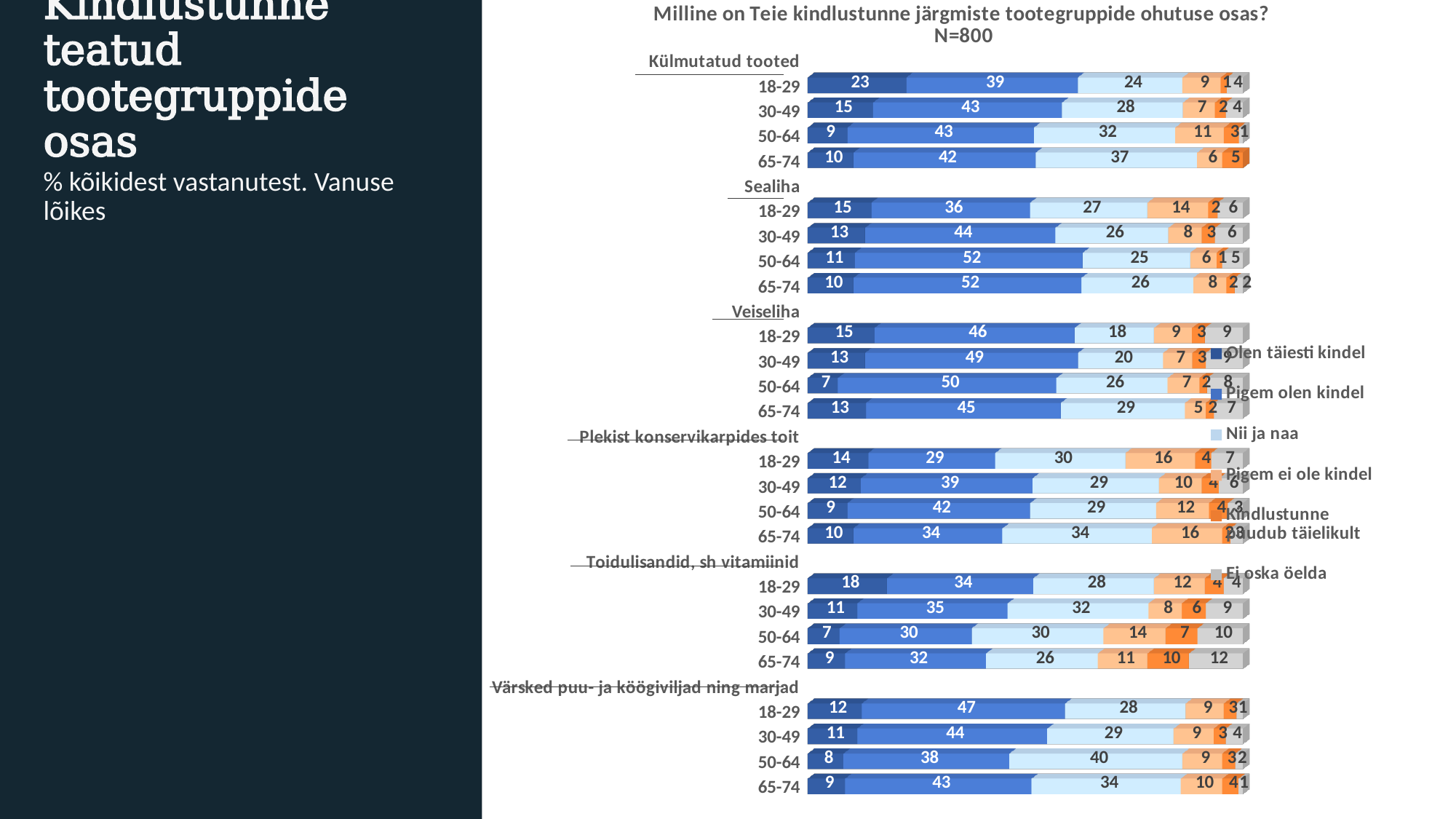
Within Veiseliha, which age group has the highest "Pigem olen kindel" value? 50-64 For Sealiha, what is the "Pigem olen kindel" value for the 50-64 age group? 52 What kind of chart is shown on the slide? Stacked bar chart For Värsked puu- ja köögiviljad ning marjad, what is the "Nii ja naa" value for the 50-64 age group? 40 For Veiseliha 30-49, what is the difference between the "Pigem olen kindel" value and the "Olen täiesti kindel" value? 36 For Külmutatud tooted, what percentage of 18-29 year olds answered "Olen täiesti kindel"? 23 What is the sample size (N) stated in the chart title? N=800 Within Toidulisandid, sh vitamiinid, which age group has the lowest "Olen täiesti kindel" value? 50-64 For Toidulisandid, sh vitamiinid, which age group has the larger "Ei oska öelda" value: 18-29 or 65-74? 65-74 How many series does the legend list? 6 Within Külmutatud tooted, which age group has the highest "Olen täiesti kindel" value? 18-29 For Plekist konservikarpides toit, what is the "Nii ja naa" value for the 18-29 age group? 30